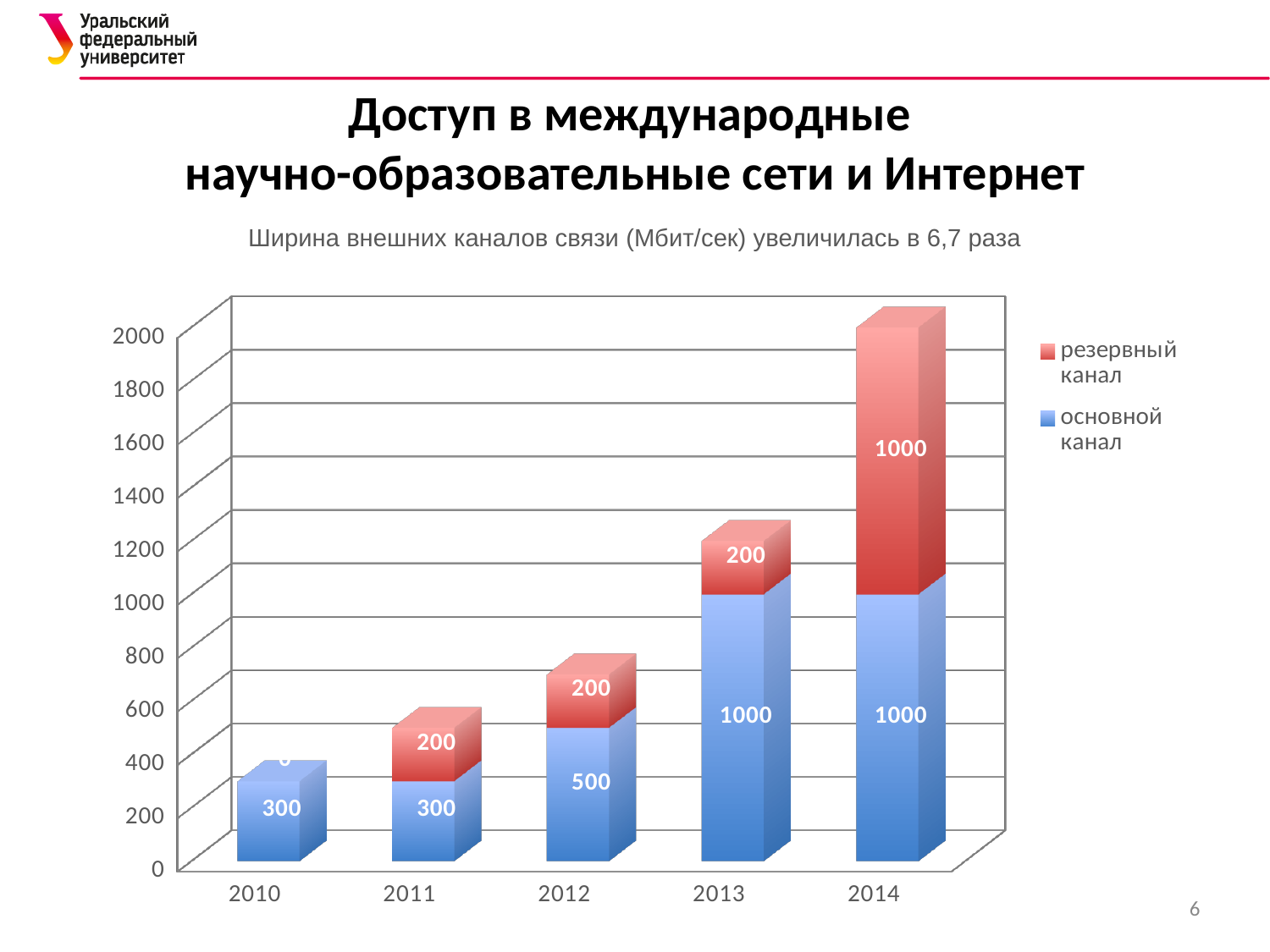
Which year has the lowest total stacked bar? 2010 How many series does the legend list? 2 What is the value of the резервный канал series for 2014? 1000 What is the difference between the основной канал values for 2013 and 2012? 500 What is the value of the резервный канал series for 2013? 200 Which is larger, the основной канал value for 2012 or for 2011? 2012 What is the value of the основной канал series for 2010? 300 What is the total of the stacked bar for 2011? 500 How many years are shown on the x axis? 5 What is the value of the основной канал series for 2012? 500 What is the total of the stacked bar for 2013? 1200 Which year has the highest total stacked bar? 2014